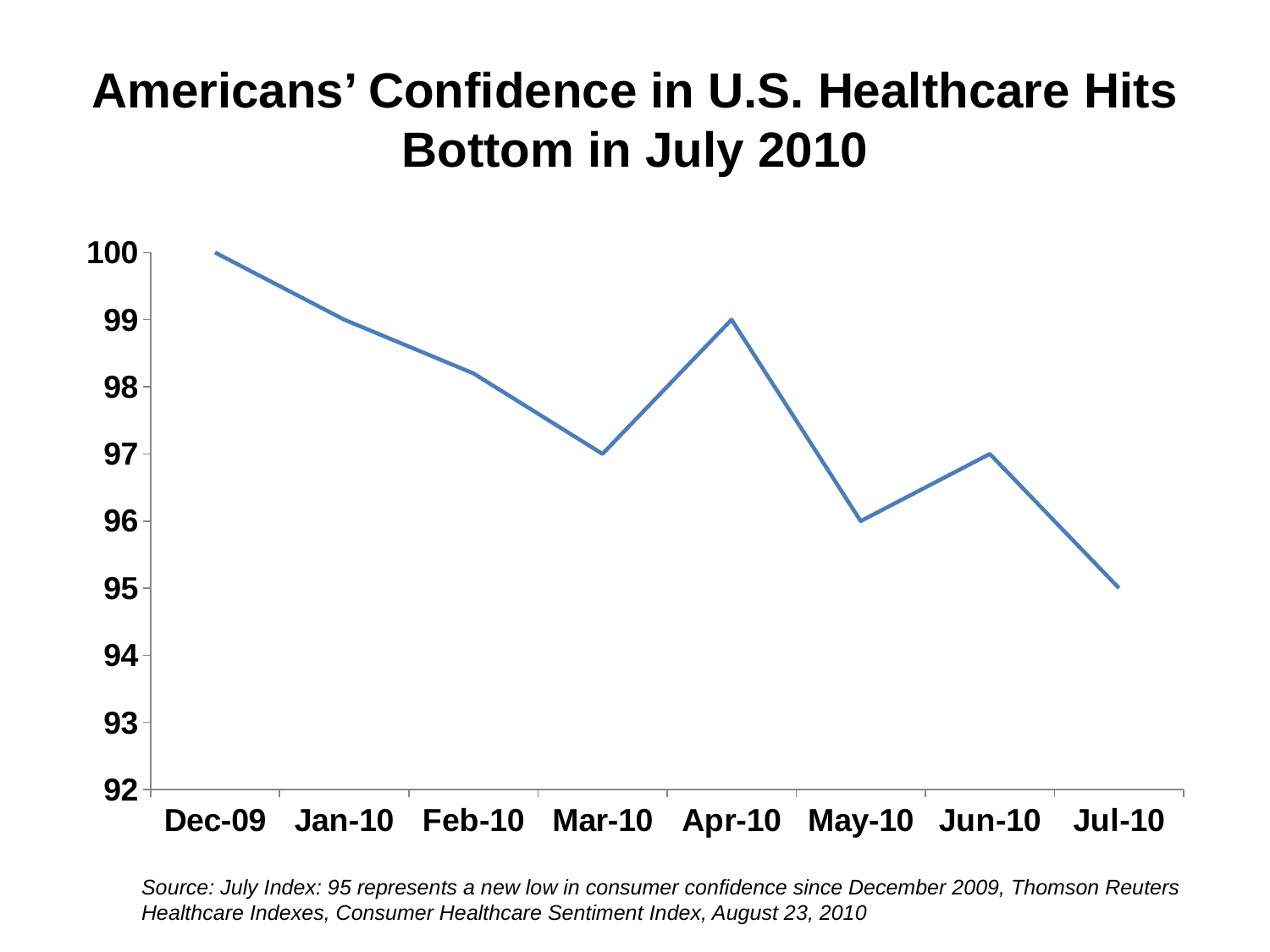
Which is larger, the value for Apr-10 or the value for May-10? Apr-10 What is the difference between the Dec-09 value and the Jul-10 value? 5 What is the index value for Dec-09? 100 Which month has the lowest index value? Jul-10 How many months are plotted on the x axis? 8 Is the value for Feb-10 greater or less than 98? greater What type of chart is shown on the slide? Line chart Overall, do the values rise or fall from Dec-09 to Jul-10? Fall Which month has the highest index value? Dec-09 What is the index value for Mar-10? 97 What is the index value for Jul-10? 95 What is the index value for May-10? 96